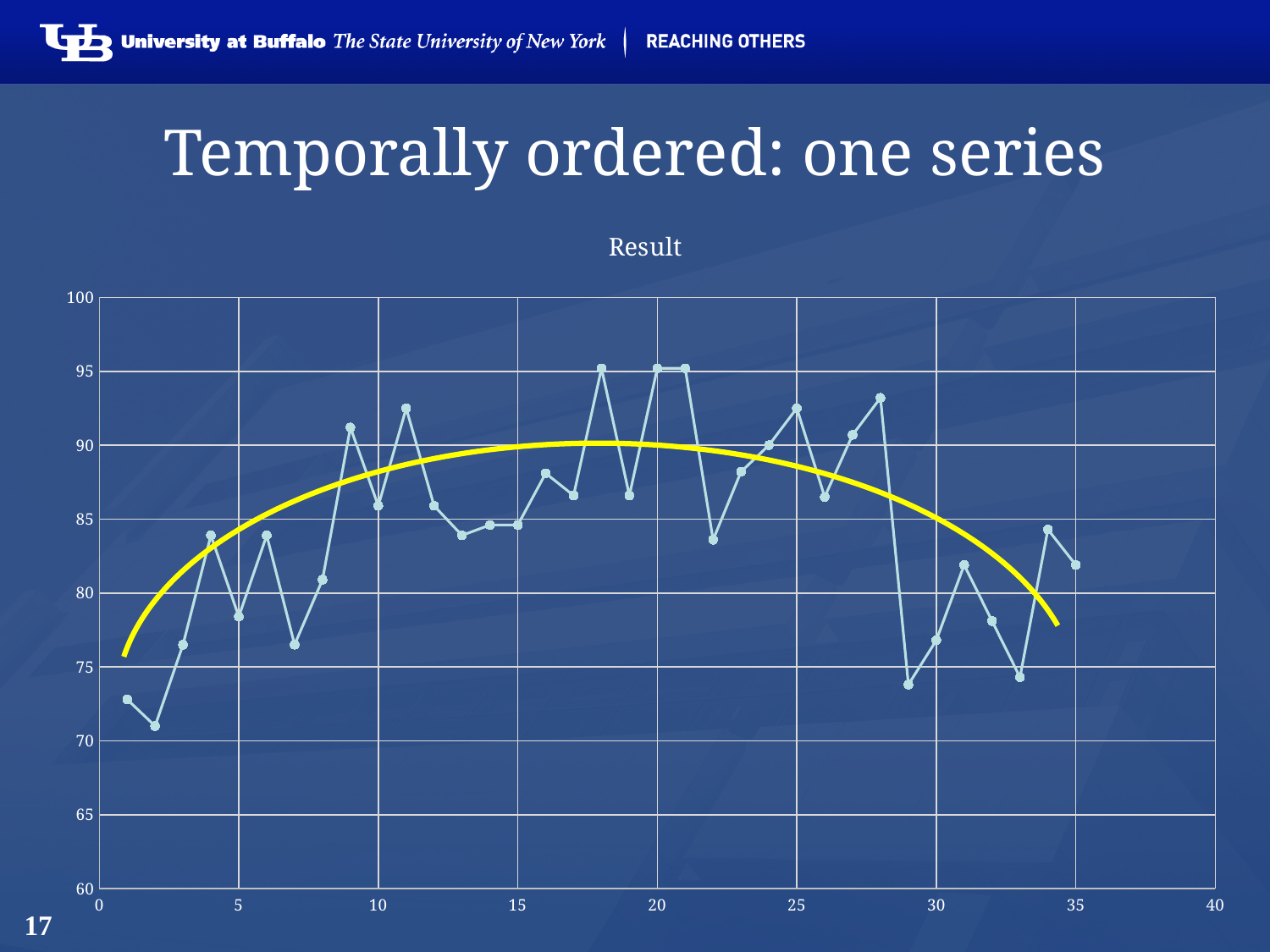
What kind of chart is shown on the slide? line chart Is the value at x = 28 greater or less than 90? greater At which x value does the series reach its lowest point? 2 Which is larger, the value at x = 2 or the value at x = 18? x = 18 Is the value at x = 2 greater or less than 75? less How many data points are plotted in the series? 35 Is the value at x = 7 greater or less than 80? less What is the title of the chart? Result What colour is the smooth trend curve drawn over the data points? yellow